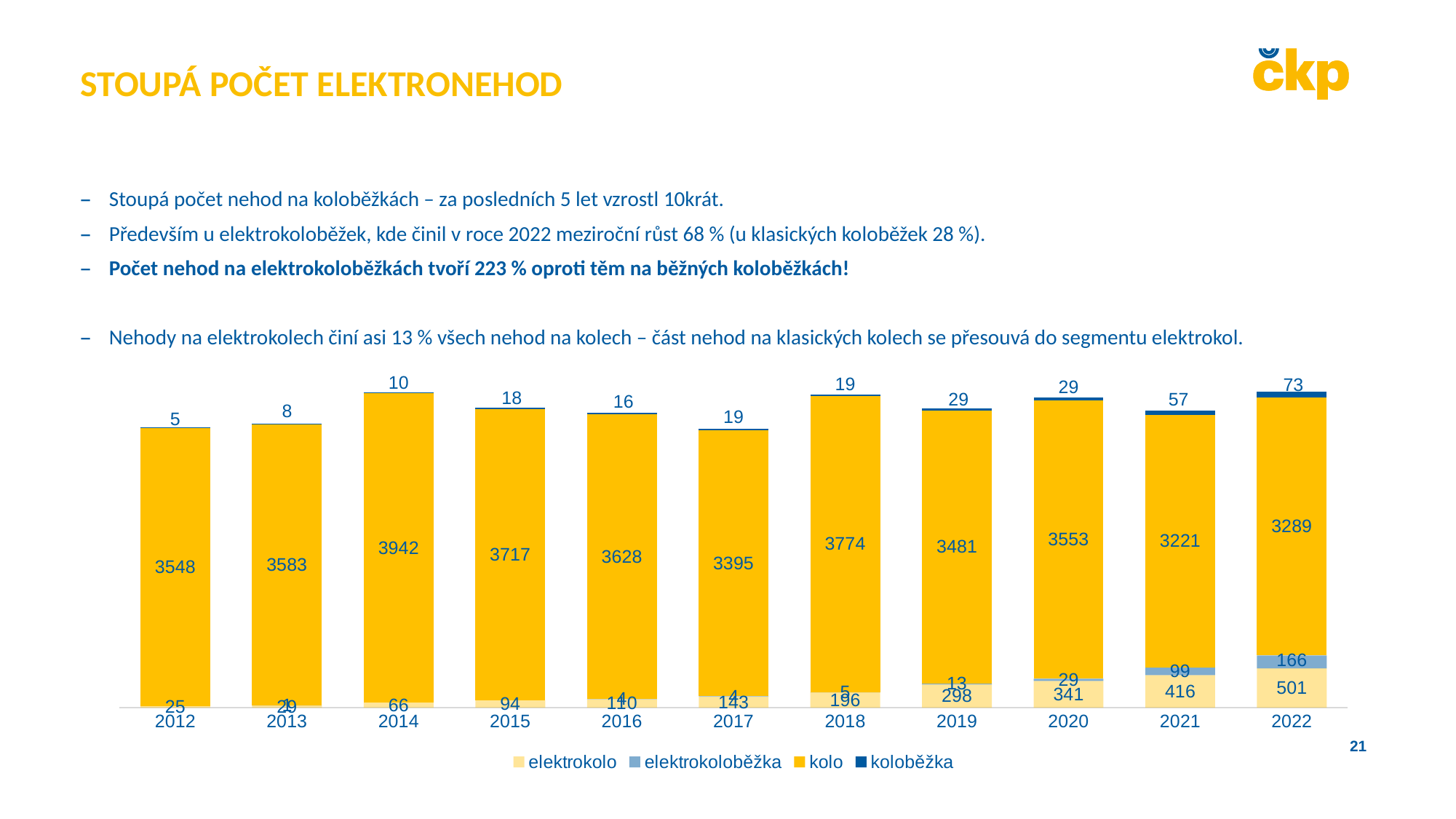
What is the value for koloběžka in 2022? 73 What is the value for kolo in 2014? 3942 What is the value for elektrokoloběžka in 2021? 99 What is the difference between the elektrokolo values for 2022 and 2021? 85 Which year has the larger koloběžka value, 2020 or 2021? 2021 What is the value for elektrokolo in 2022? 501 How many years are shown on the x axis? 11 How many series does the legend list? 4 What is the total of the stacked bar for 2022? 4029 In which year is the kolo value lowest? 2021 What kind of chart is shown on the slide? stacked bar chart In which year is the kolo value highest? 2014